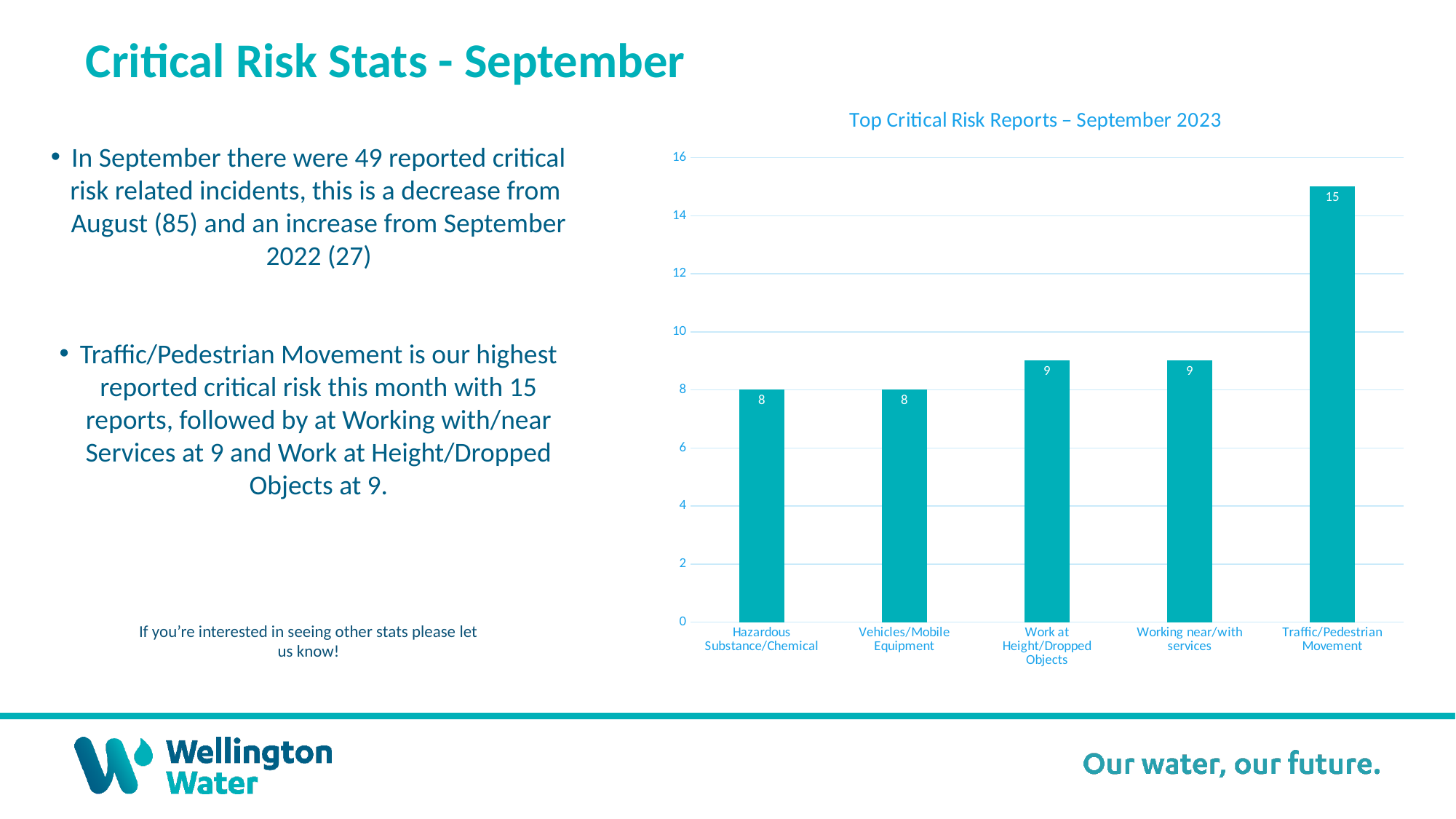
What is the difference between Work at Height/Dropped Objects and Vehicles/Mobile Equipment? 1 What is the value for Hazardous Substance/Chemical? 8 What is the value for Work at Height/Dropped Objects? 9 How many categories are shown on the chart? 5 Which category has the highest value? Traffic/Pedestrian Movement What kind of chart is shown? bar chart What is the value for Vehicles/Mobile Equipment? 8 What is the value for Traffic/Pedestrian Movement? 15 Which is larger, Working near/with services or Hazardous Substance/Chemical? Working near/with services What is the difference between Traffic/Pedestrian Movement and Working near/with services? 6 Is the value for Traffic/Pedestrian Movement greater or less than 14? greater What is the title of the chart? Top Critical Risk Reports – September 2023